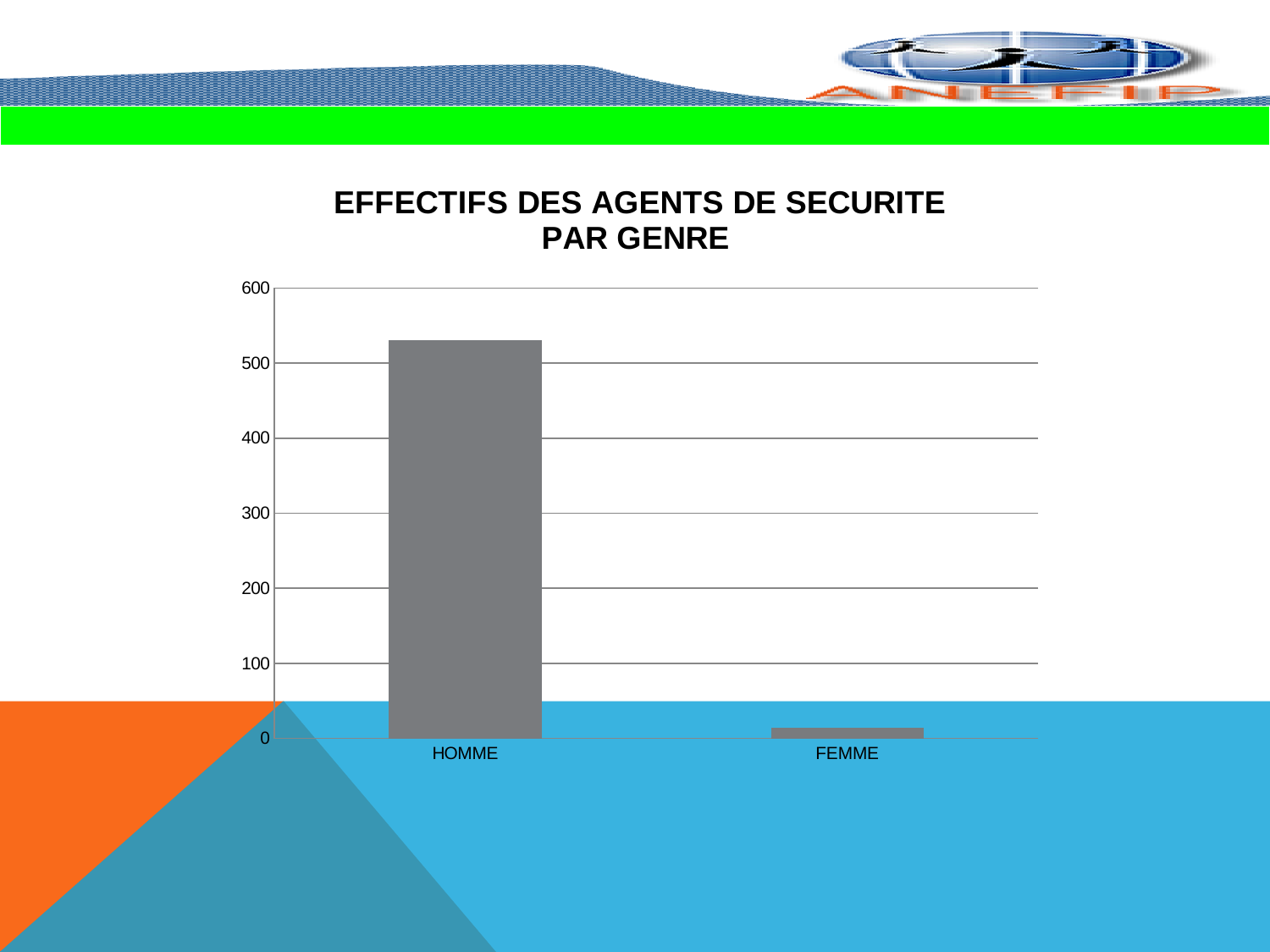
How many categories are shown on the x axis of the chart? 2 Is the value for FEMME greater or less than 100? less Which category has the lowest value in the chart? FEMME Is the value for HOMME greater or less than 400? greater Which is larger, the value for HOMME or the value for FEMME? HOMME Is the value for HOMME greater or less than 600? less What is the highest value shown on the vertical axis of the chart? 600 What is the title of the chart? EFFECTIFS DES AGENTS DE SECURITE PAR GENRE Which category has the highest value in the chart? HOMME What kind of chart is shown on the slide? bar chart Do the values rise or fall going from HOMME to FEMME along the x axis? fall